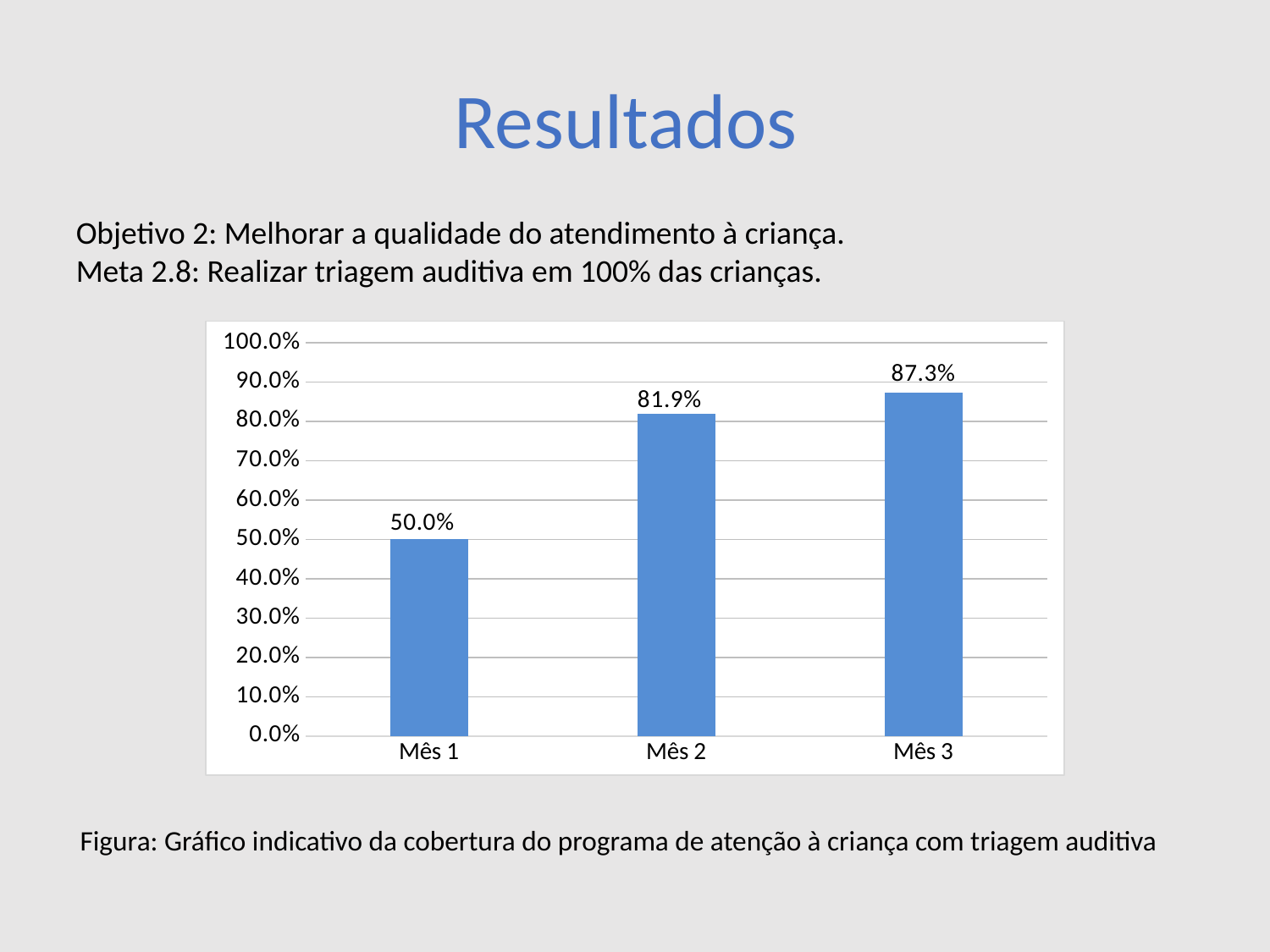
Do the values rise or fall from Mês 1 to Mês 3? rise What is the value for Mês 3? 87.3% What is the value for Mês 1? 50.0% How many categories are shown on the x axis? 3 What is the difference between the values for Mês 3 and Mês 2? 5.4% What is the difference between the values for Mês 2 and Mês 1? 31.9% Is the value for Mês 3 greater or less than 80.0%? greater Which is larger, the value for Mês 1 or the value for Mês 2? Mês 2 What is the value for Mês 2? 81.9% What kind of chart is shown on the slide? bar chart Which month has the highest value? Mês 3 Which month has the lowest value? Mês 1